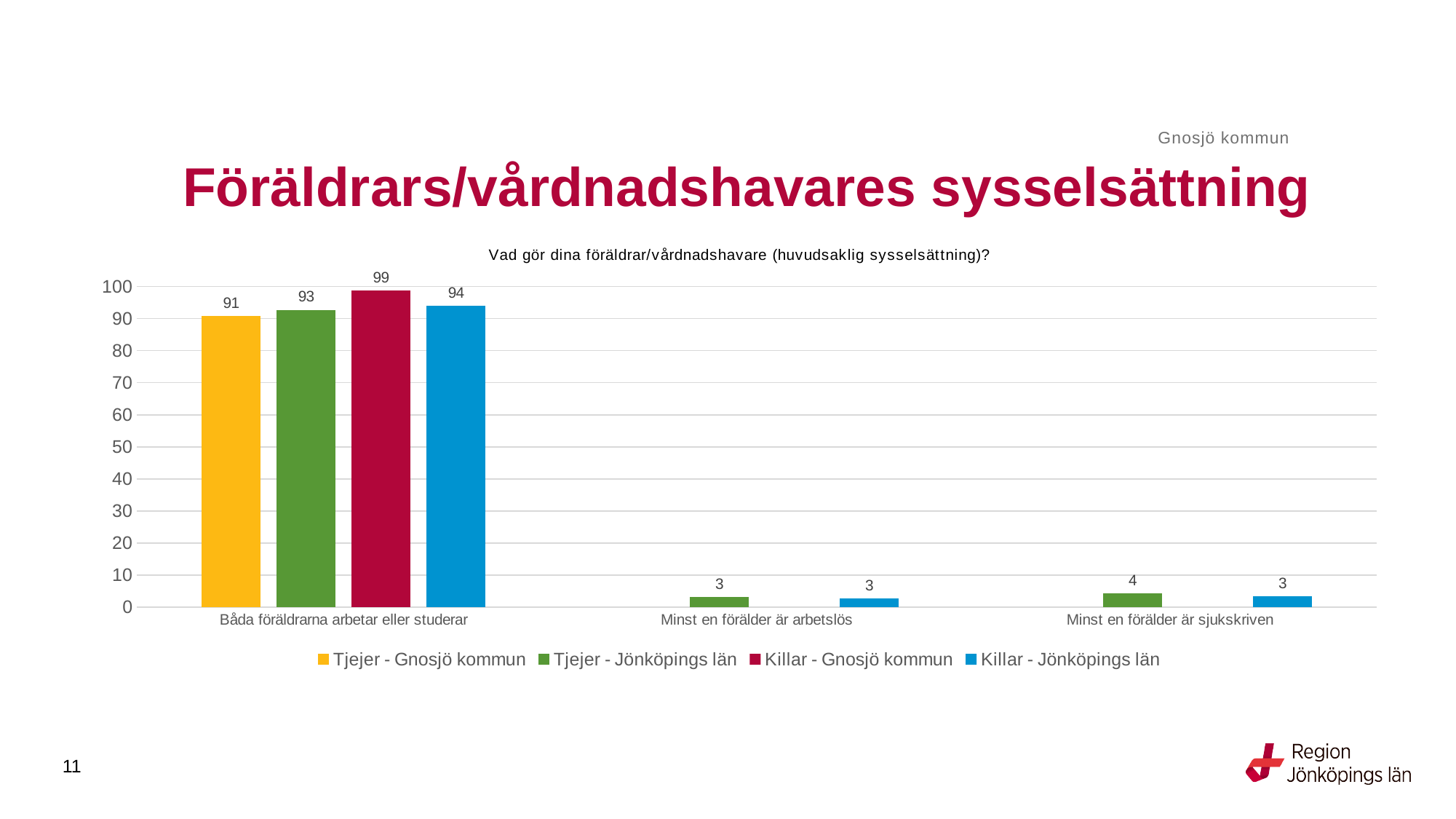
What is the difference between Killar - Gnosjö kommun and Tjejer - Gnosjö kommun in the category 'Båda föräldrarna arbetar eller studerar'? 8 How many series does the legend list? 4 Which is larger in the category 'Båda föräldrarna arbetar eller studerar': Tjejer - Jönköpings län or Killar - Jönköpings län? Killar - Jönköpings län What is the value for Killar - Gnosjö kommun in the category 'Båda föräldrarna arbetar eller studerar'? 99 Is the value for Tjejer - Jönköpings län in 'Båda föräldrarna arbetar eller studerar' greater or less than 90? greater What is the value for Tjejer - Gnosjö kommun in the category 'Båda föräldrarna arbetar eller studerar'? 91 What kind of chart is shown on the slide? Bar chart Which series has the highest value in the category 'Båda föräldrarna arbetar eller studerar'? Killar - Gnosjö kommun What is the value for Tjejer - Jönköpings län in the category 'Minst en förälder är sjukskriven'? 4 How many categories are shown on the x axis? 3 What is the value for Killar - Jönköpings län in the category 'Minst en förälder är arbetslös'? 3 Which series has the lowest value in the category 'Båda föräldrarna arbetar eller studerar'? Tjejer - Gnosjö kommun